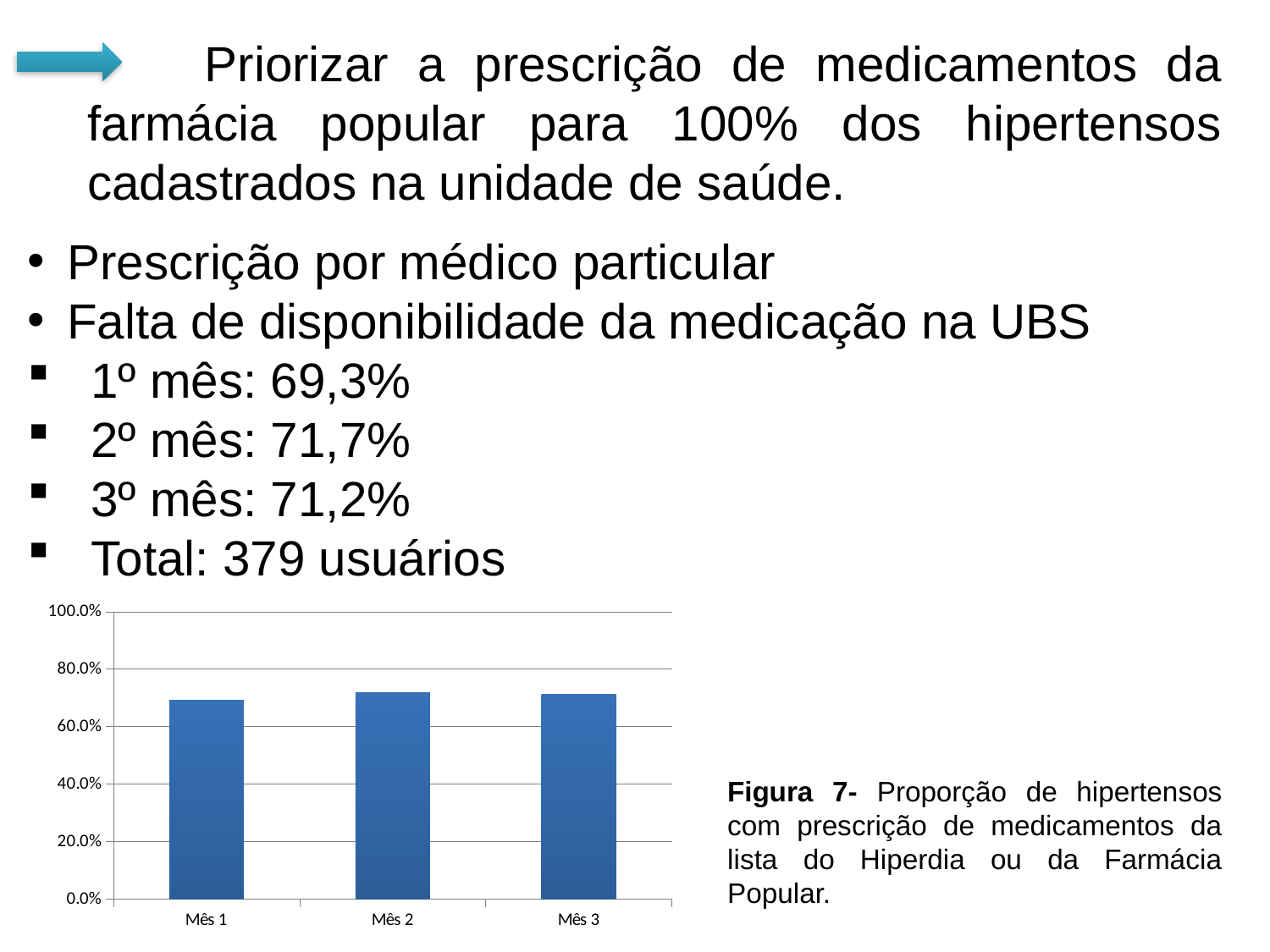
Is the value for Mês 3 greater or less than 80.0%? less What is the label of the first category on the x axis? Mês 1 What is the highest value shown on the y axis of the chart? 100.0% Is the value for Mês 2 greater or less than 60.0%? greater Is the value for Mês 2 greater or less than 80.0%? less What kind of chart is shown on the slide? bar chart How many bars (months) are plotted in the chart? 3